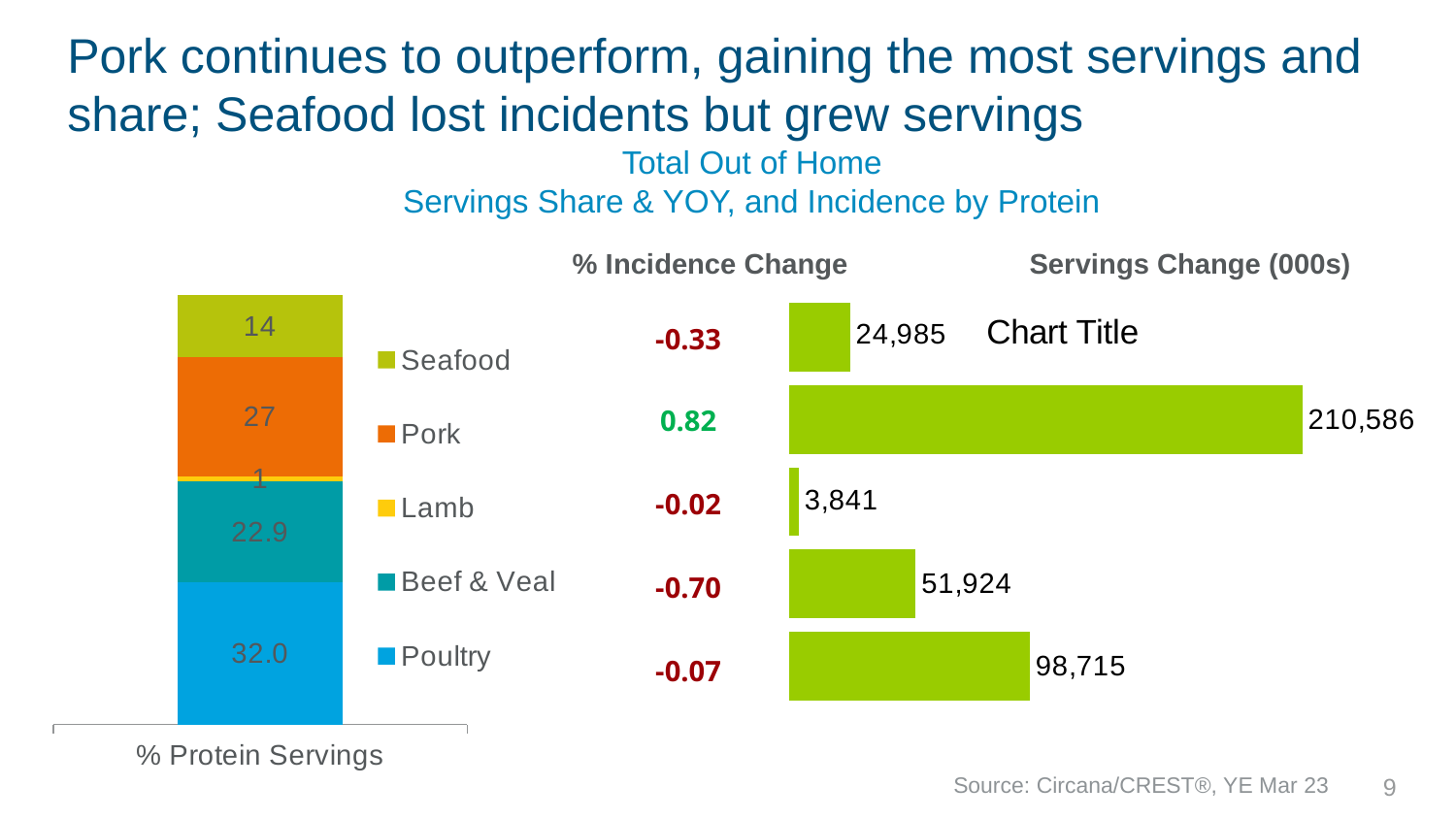
In the stacked bar chart on the left (% Protein Servings), what is the value for Beef & Veal? 22.9 What kind of chart is the Servings Change (000s) chart on the right? Bar chart In the stacked bar chart on the left (% Protein Servings), what is the value for Poultry? 32.0 In the stacked bar chart on the left (% Protein Servings), which protein has the largest segment? Poultry In the Servings Change (000s) bar chart on the right, what is the value of the bottom bar (Poultry)? 98,715 In the stacked bar chart on the left (% Protein Servings), which protein has the smallest segment? Lamb In the stacked bar chart on the left (% Protein Servings), what is the value for Pork? 27 In the Servings Change (000s) bar chart on the right, what is the difference between the Pork bar (210,586) and the Poultry bar (98,715)? 111,871 How many entries does the legend of the stacked bar chart on the left list? 5 In the stacked bar chart on the left (% Protein Servings), what is the difference between the Pork and Seafood values? 13 In the Servings Change (000s) bar chart on the right, what is the value of the longest bar? 210,586 In the Servings Change (000s) bar chart on the right, what is the value of the shortest bar? 3,841